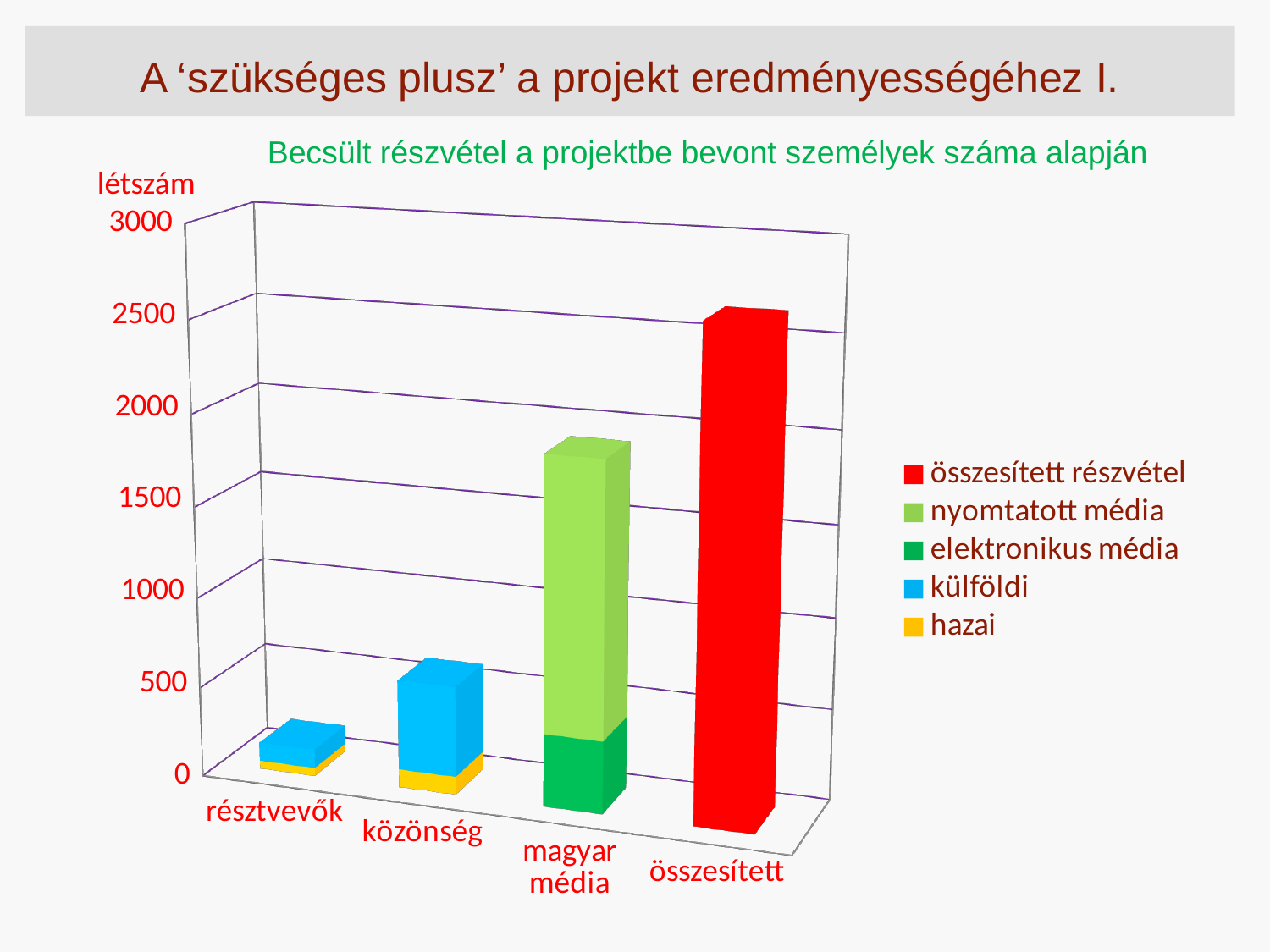
Is the total value for közönség greater or less than 1000? less Which bar is taller, közönség or résztvevők? közönség What is the title of the chart? Becsült részvétel a projektbe bevont személyek száma alapján Is the total value for résztvevők greater or less than 500? less Is the value for összesített greater or less than 2000? greater Which category has the shortest bar in the chart? résztvevők What kind of chart is shown on the slide? bar chart Which category has the tallest bar in the chart? összesített How many categories are shown on the x axis of the chart? 4 How many series does the chart's legend list? 5